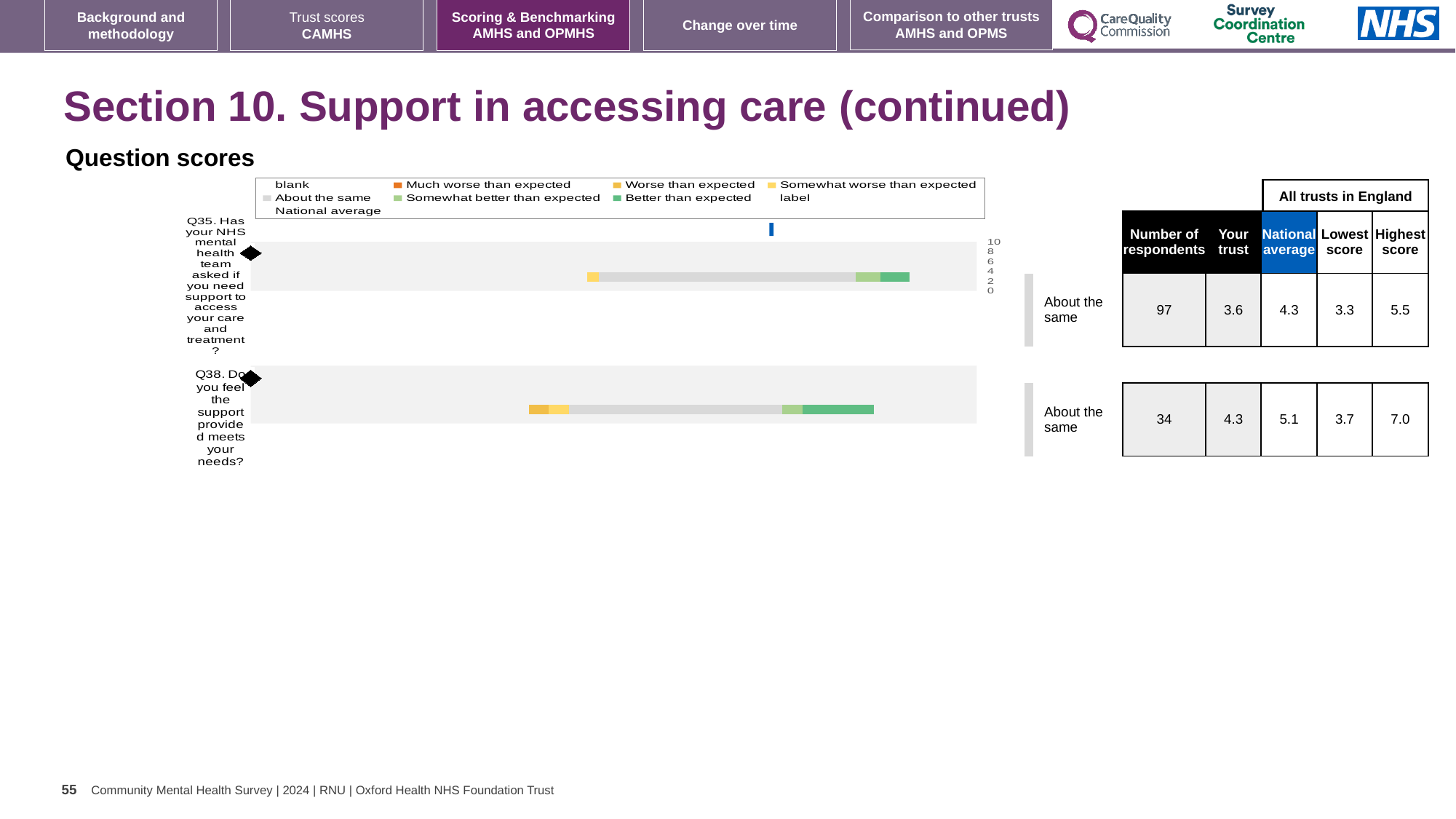
For Q35, which is larger, the national average or the 'Your trust' score? national average What is the national average score for Q38? 5.1 Which two questions are plotted in the chart? Q35 and Q38 For Q38, what is the difference between the highest score and the lowest score among all trusts in England? 3.3 What colour does the legend use for 'Better than expected'? green What is the highest score among all trusts in England for Q35? 5.5 What kind of chart is shown under 'Question scores'? bar chart What is the 'Your trust' score for Q35? 3.6 How many survey questions are plotted in the chart? 2 How many respondents answered Q35? 97 Which question has the higher 'Your trust' score, Q35 or Q38? Q38 What benchmark category is shown for Q38? About the same